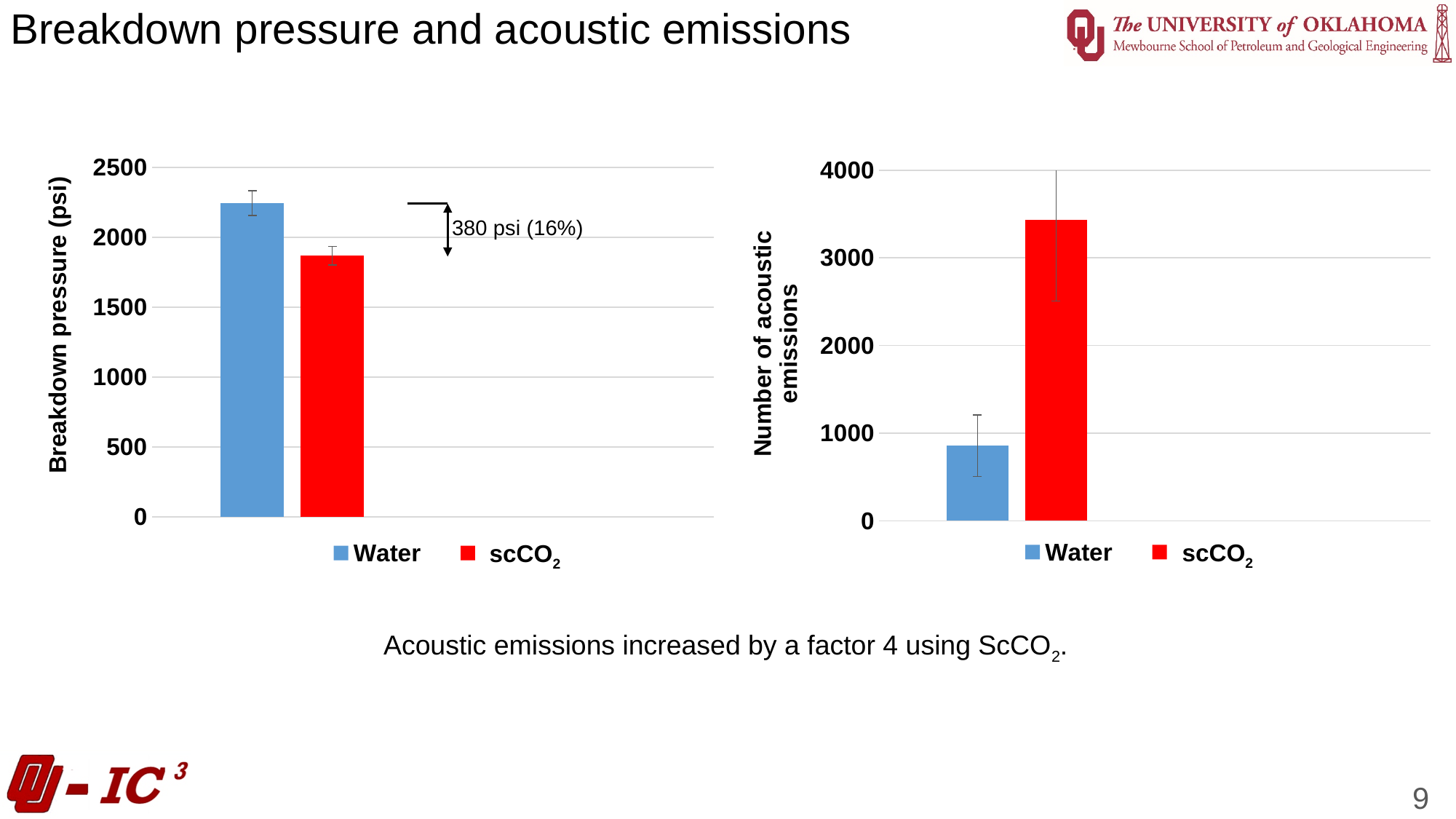
On the left chart (Breakdown pressure), what difference between the Water and scCO2 bars is annotated on the chart? 380 psi (16%) On the right chart (Number of acoustic emissions), which series has the higher number of acoustic emissions? scCO2 What kind of chart is the right chart (Number of acoustic emissions)? Bar chart On the right chart (Number of acoustic emissions), is the value for Water greater or less than 1000? less On the left chart (Breakdown pressure), which series has the higher breakdown pressure, Water or scCO2? Water What is the y-axis label of the left chart? Breakdown pressure (psi) How many bars are plotted on the right chart (Number of acoustic emissions)? 2 On the right chart (Number of acoustic emissions), which series has the lowest value? Water How many series does the legend of the left chart (Breakdown pressure) list? 2 On the left chart (Breakdown pressure), is the value for Water greater or less than 2000? greater On the right chart (Number of acoustic emissions), is the value for scCO2 greater or less than 3000? greater